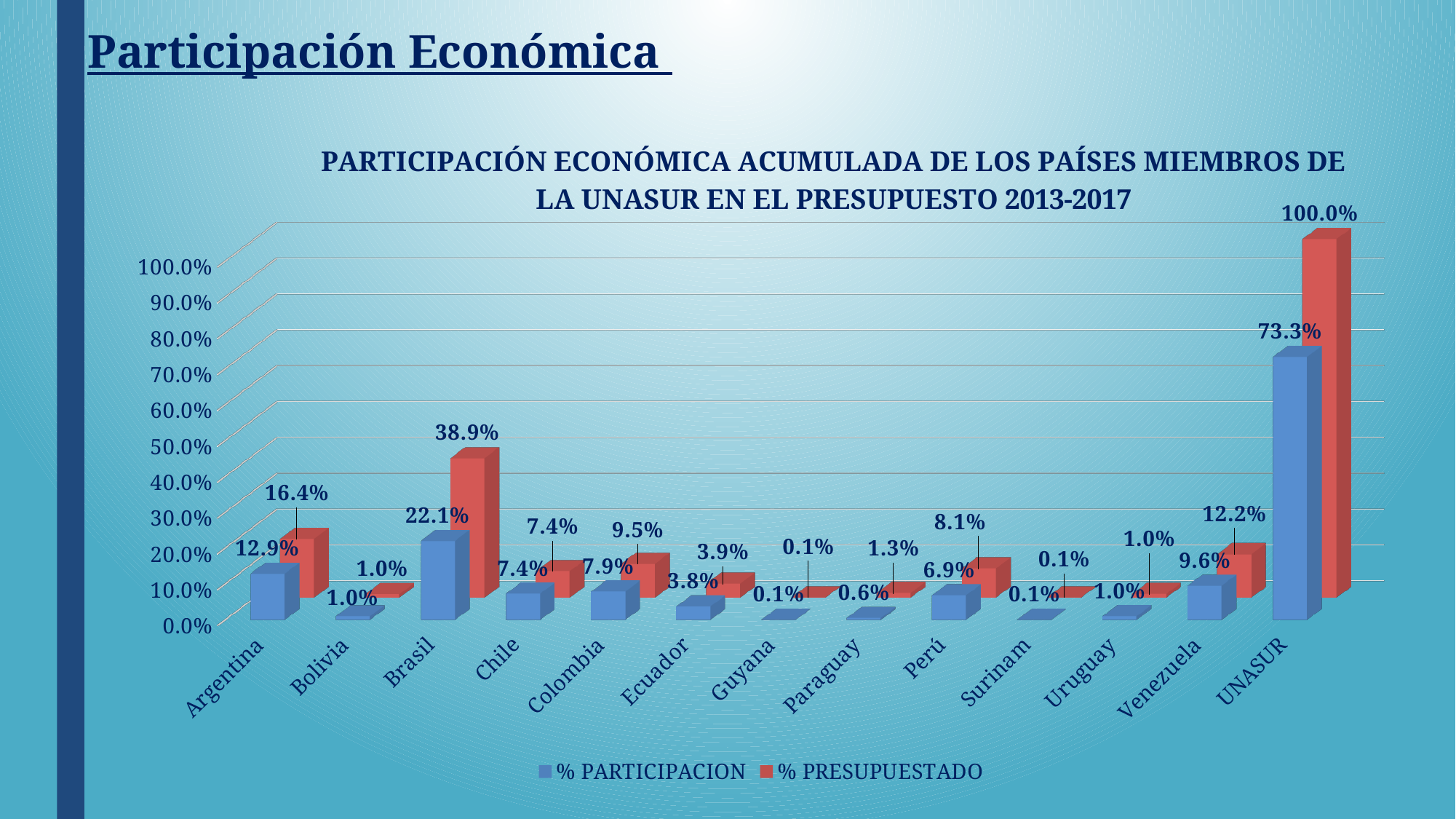
What kind of chart is shown on the slide? Bar chart Among the individual countries (excluding UNASUR), which has the highest % PARTICIPACION value? Brasil How many series does the legend list? 2 What is the % PRESUPUESTADO value for Brasil? 38.9% What is the difference between the % PRESUPUESTADO values for Argentina and Venezuela? 4.2% What is the % PARTICIPACION value for Argentina? 12.9% How many categories are shown on the x axis? 13 Which is larger, the % PARTICIPACION value for Colombia or for Perú? Colombia What is the % PRESUPUESTADO value for Venezuela? 12.2% What is the % PARTICIPACION value for UNASUR? 73.3% Which category has the highest % PRESUPUESTADO value? UNASUR What is the difference between the % PRESUPUESTADO and % PARTICIPACION values for Brasil? 16.8%